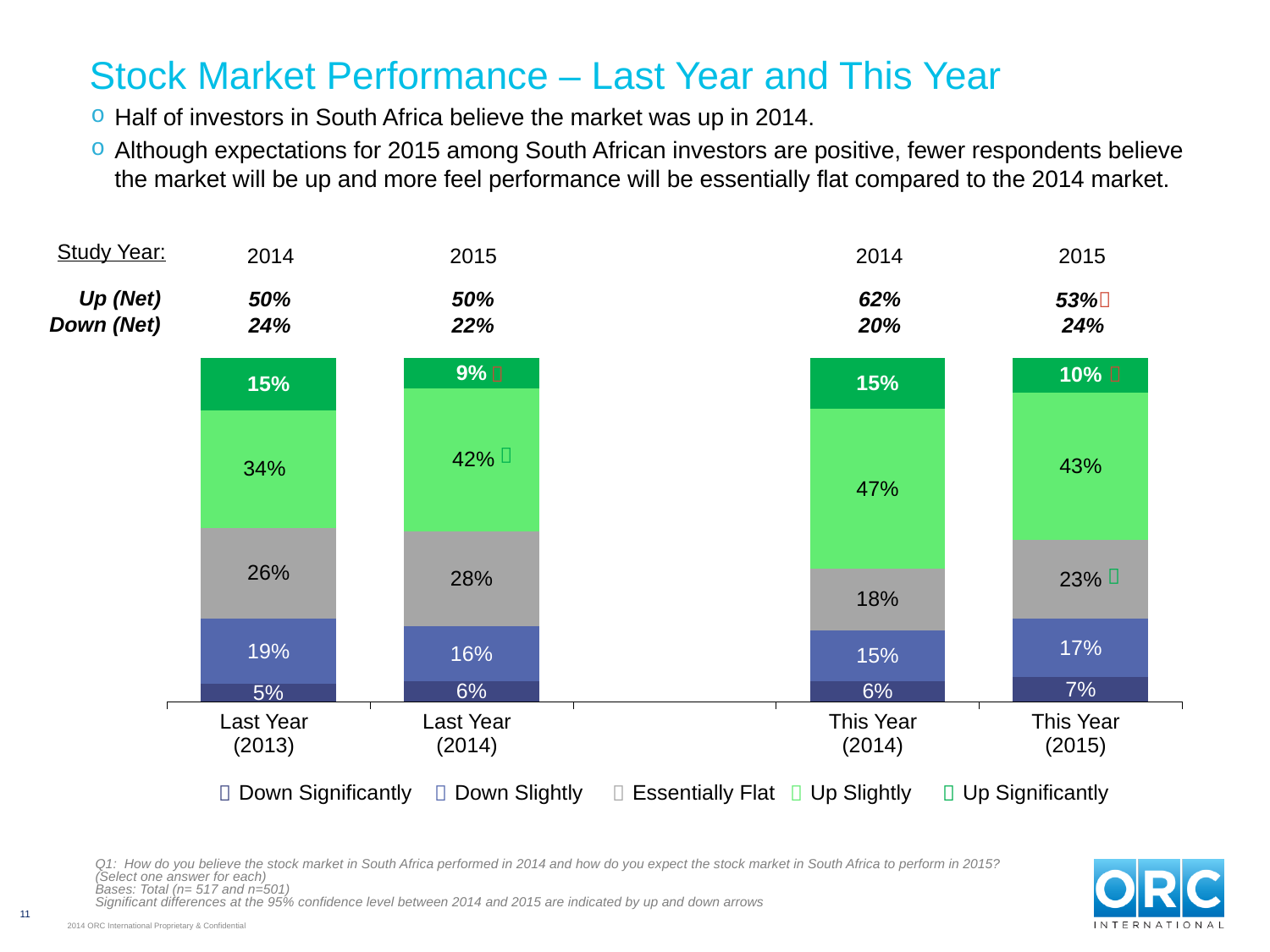
What is the Essentially Flat value for Last Year (2014)? 28% Which bar has the highest Up Slightly value? This Year (2014) What is the Down Slightly value for Last Year (2013)? 19% What is the Up Significantly value for This Year (2015)? 10% What is the difference between the Essentially Flat values for Last Year (2013) and This Year (2014)? 8% Which is larger: the Up Significantly value for Last Year (2013) or for Last Year (2014)? Last Year (2013) What type of chart is shown on the slide? Stacked bar chart What is the Up (Net) value shown above the This Year (2014) bar? 62% What is the Up Slightly value for This Year (2014)? 47% Which bar has the lowest Down Significantly value? Last Year (2013) How many series does the legend list? 5 How many bars are plotted in the chart? 4